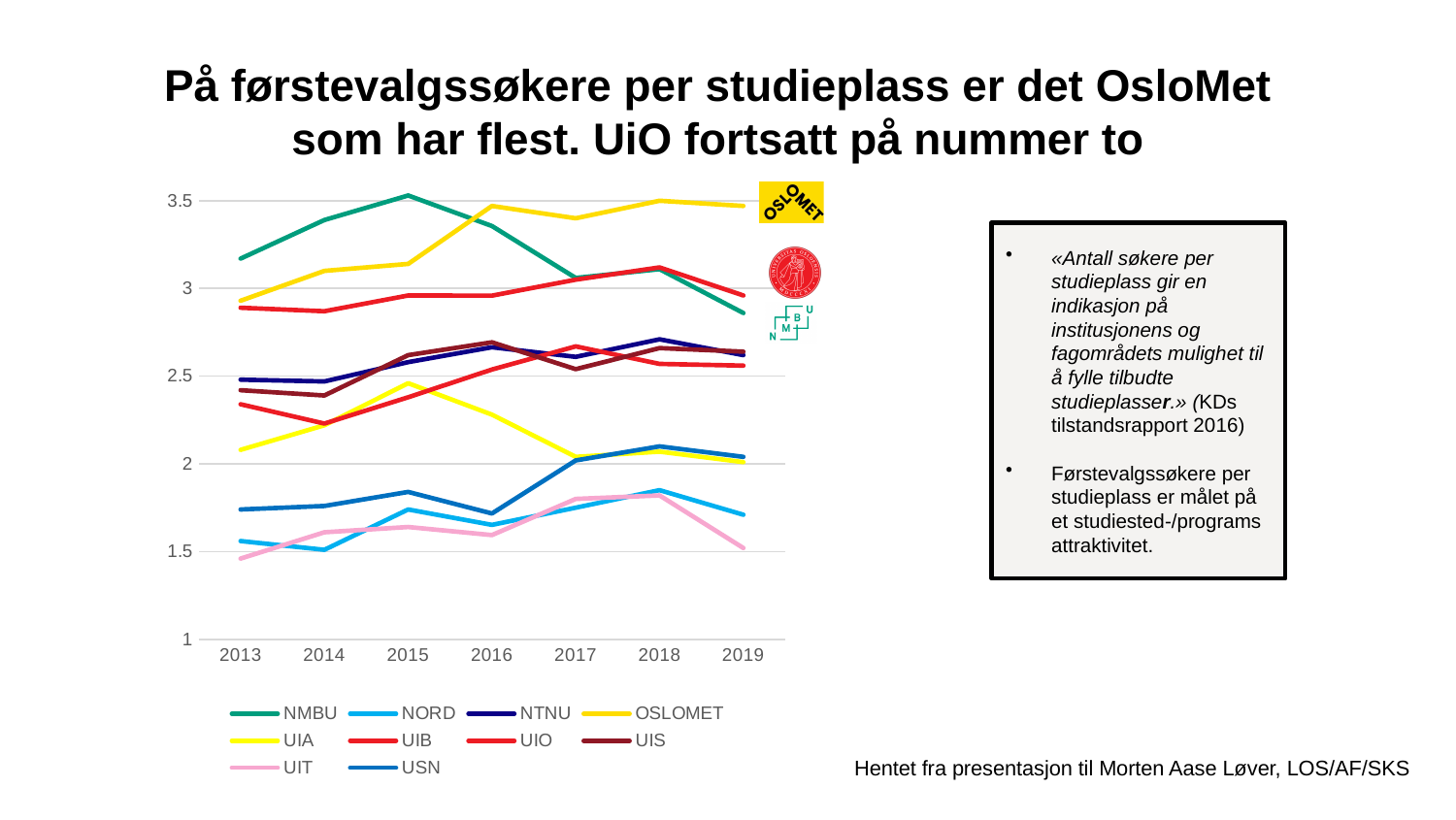
Is the value for NMBU in 2019 greater or less than 3? less What kind of chart is shown on the slide? Line chart Does the OSLOMET line generally rise or fall from 2013 to 2019? Rise Is the value for USN in 2013 greater or less than 2? less Which institution has the highest value in 2015? NMBU Is the value for NMBU in 2015 greater or less than 3? greater Which institution has the lowest value in 2013? UIT In 2013, which is larger: the value for NMBU or the value for OSLOMET? NMBU How many series does the legend of the chart list? 10 How many years are shown along the x axis of the chart? 7 Which institution has the lowest value in 2019? UIT Which institution has the highest value in 2019? OSLOMET